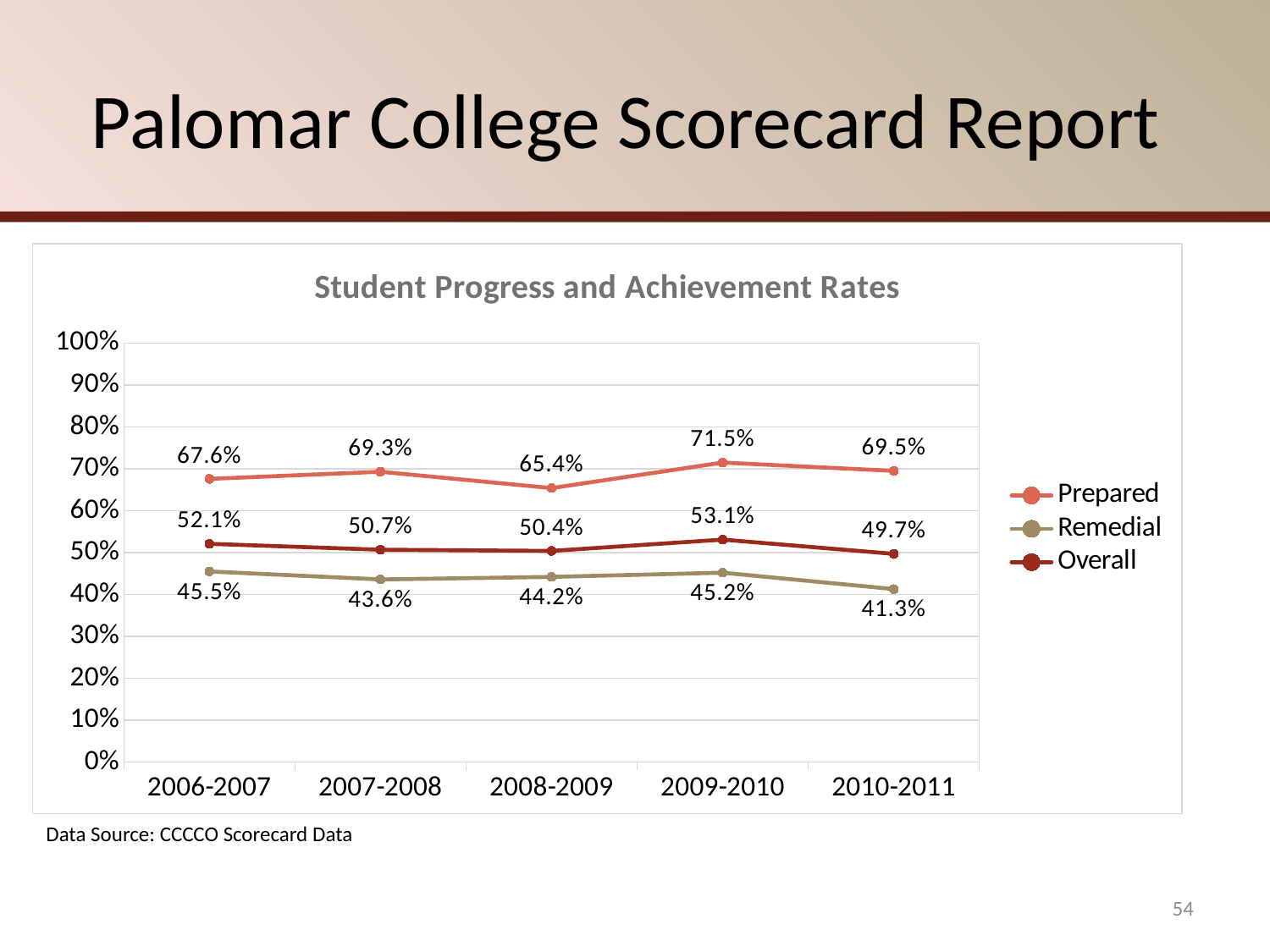
How many series does the legend list? 3 Is the Prepared rate for 2007-2008 greater or less than 60%? greater What is the Remedial rate for 2010-2011? 41.3% Which is larger, the Overall rate in 2009-2010 or the Overall rate in 2010-2011? 2009-2010 What kind of chart is shown? line chart In which year is the Remedial rate lowest? 2010-2011 What is the Overall rate for 2006-2007? 52.1% What is the Prepared rate for 2009-2010? 71.5% What is the title of the chart? Student Progress and Achievement Rates How many academic years are shown on the x axis? 5 What is the difference between the Prepared and Remedial rates in 2008-2009? 21.2% In which year is the Prepared rate highest? 2009-2010